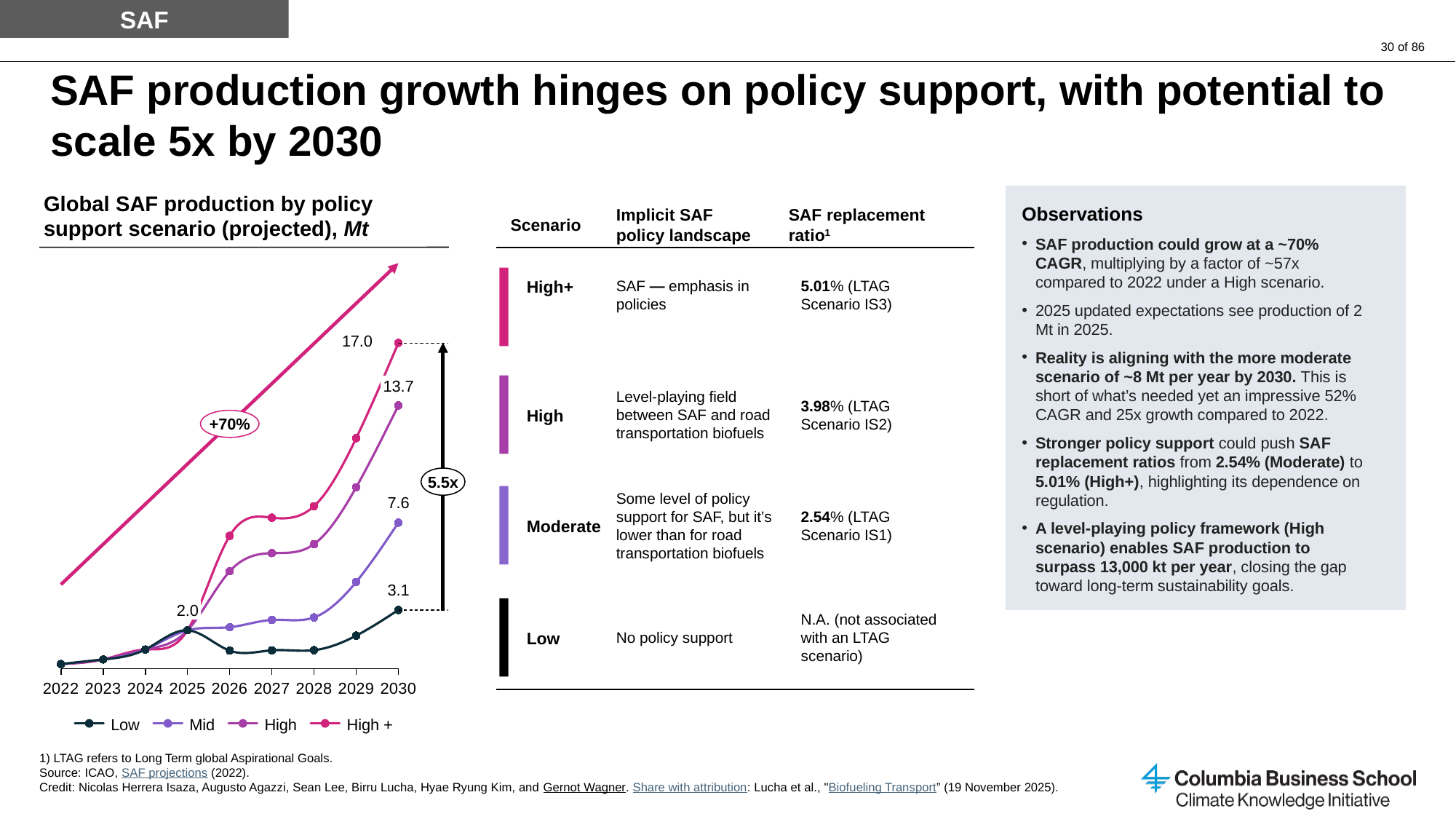
Which series has the lowest value in 2030? Low What type of chart is shown on the slide? line chart What is the projected value for the Low series in 2030? 3.1 How many years are shown on the x axis? 9 What unit is given in the chart title? Mt Which series has the highest value in 2030? High + What is the projected value for the High + series in 2030? 17.0 What is the difference between the High + and High values in 2030? 3.3 What value is labelled on the chart for 2025? 2.0 What is the projected value for the Mid series in 2030? 7.6 How many series does the chart legend list? 4 What is the projected value for the High series in 2030? 13.7